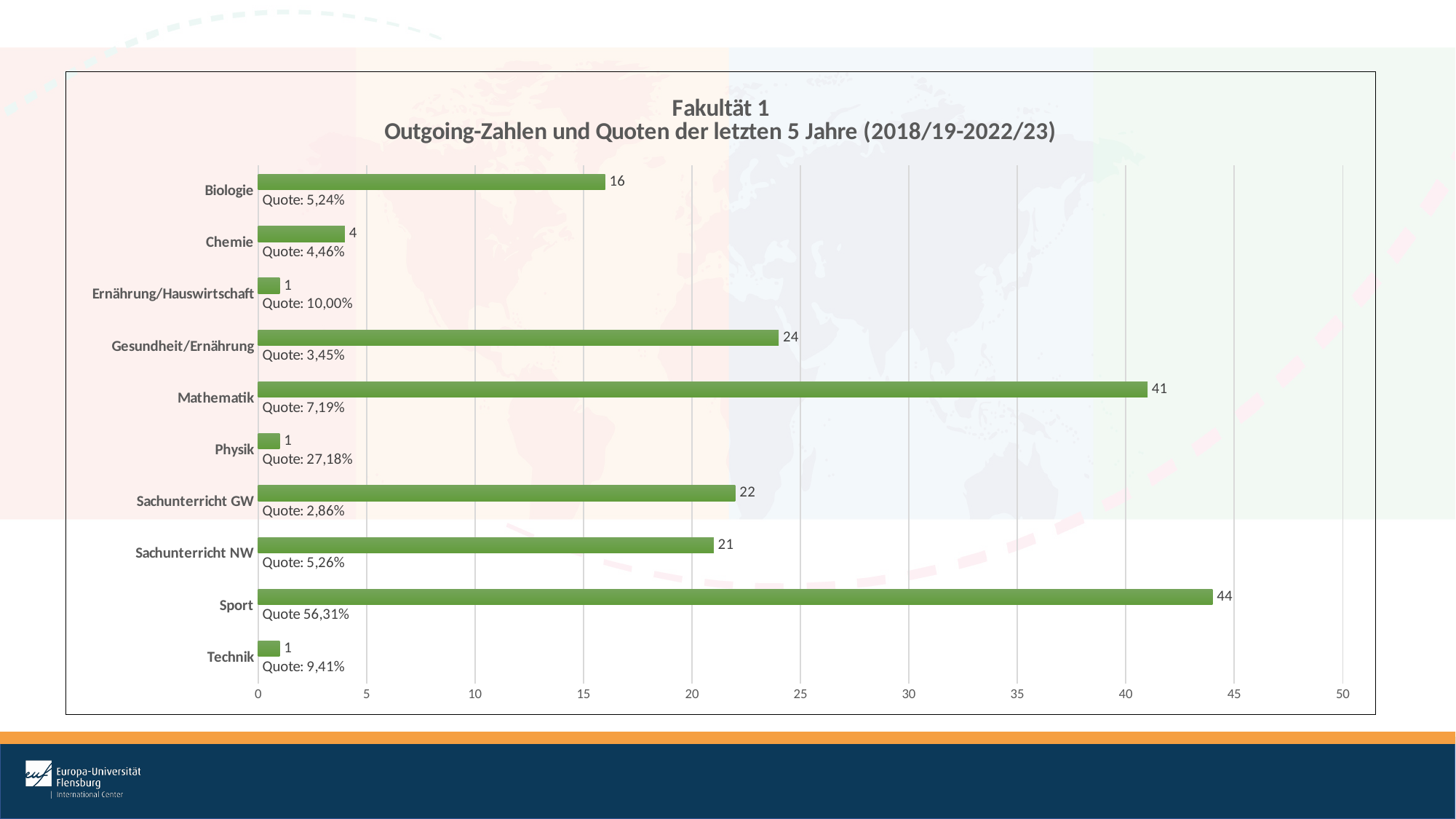
What is the value for Mathematik? 41 What is the Quote shown for Physik? 27,18% What is the difference between the values for Biologie and Chemie? 12 What is the title of the chart? Fakultät 1 Outgoing-Zahlen und Quoten der letzten 5 Jahre (2018/19-2022/23) Is the value for Biologie greater or less than 20? less What is the value for Gesundheit/Ernährung? 24 What is the difference between the values for Sport and Mathematik? 3 What kind of chart is shown on the slide? bar chart Which is larger, the value for Sachunterricht GW or Sachunterricht NW? Sachunterricht GW How many categories are shown on the chart? 10 What is the Quote shown for Sport? 56,31% Which category has the highest value? Sport